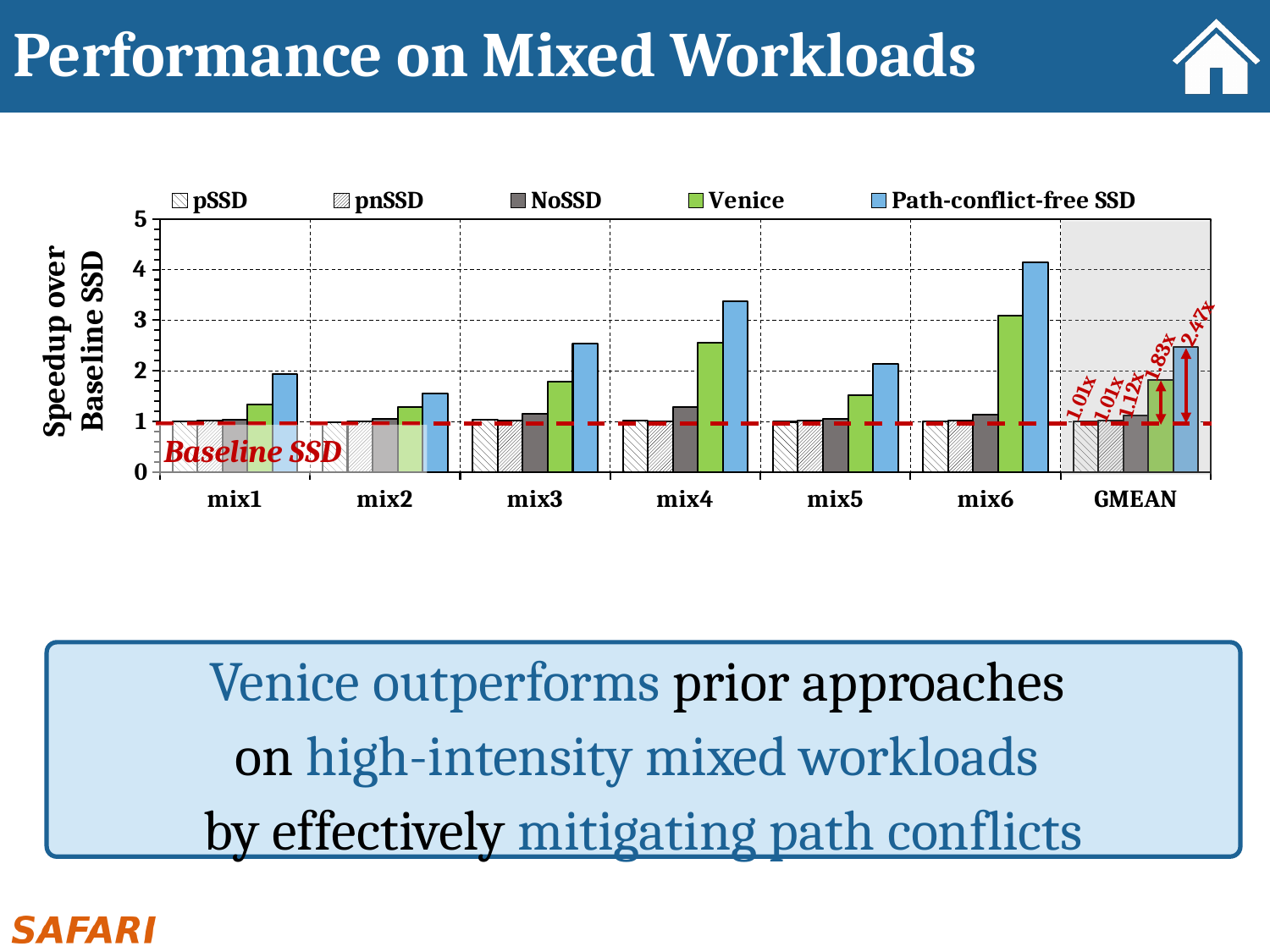
How many series does the legend list? 5 What is the y-axis title of the chart? Speedup over Baseline SSD Is the Venice speedup for mix5 greater or less than 2? less Which is larger, the Venice speedup for mix3 or for mix4? mix4 Which workload has the highest Path-conflict-free SSD speedup? mix6 What is the GMEAN speedup for pSSD? 1.01x What is the difference between the GMEAN speedups of Path-conflict-free SSD and Venice? 0.64x Which workload has the lowest Path-conflict-free SSD speedup? mix2 Is the Path-conflict-free SSD speedup for mix6 greater or less than 4? greater What is the GMEAN speedup for NoSSD? 1.12x What is the GMEAN speedup for Venice? 1.83x What is the GMEAN speedup for Path-conflict-free SSD? 2.47x